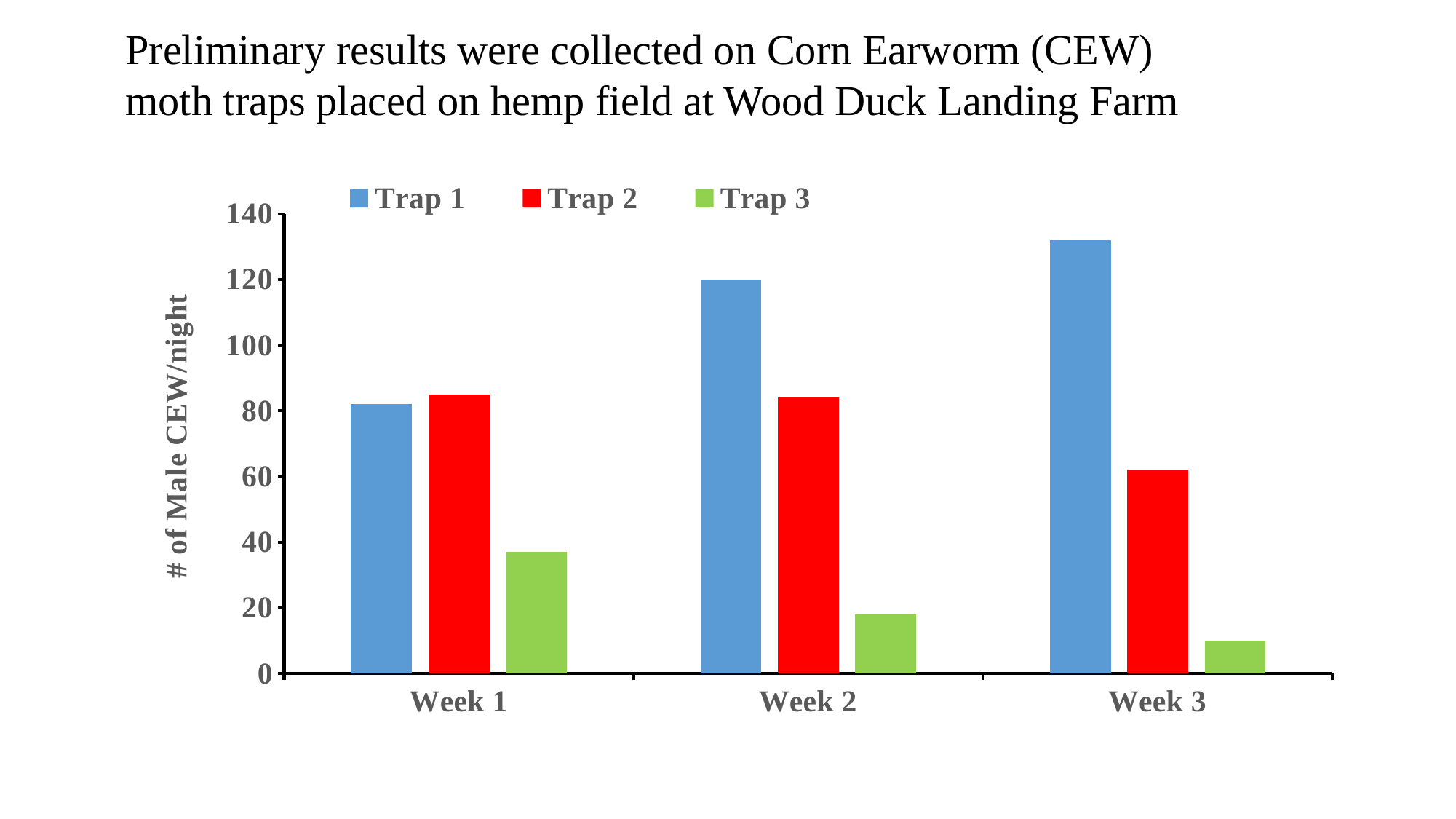
In which week is the Trap 3 value lowest? Week 3 Is the value for Trap 2 in Week 3 greater or less than 80? less Do the Trap 1 values rise or fall from Week 1 to Week 3? rise Is the value for Trap 3 in Week 1 greater or less than 40? less How many week categories are shown on the x axis? 3 In Week 2, which is larger: Trap 1 or Trap 2? Trap 1 In which week is the Trap 1 value highest? Week 3 Is the value for Trap 1 in Week 3 greater or less than 120? greater Do the Trap 3 values rise or fall from Week 1 to Week 3? fall What kind of chart is shown on the slide? bar chart What is the label on the y axis? # of Male CEW/night How many series does the legend list? 3